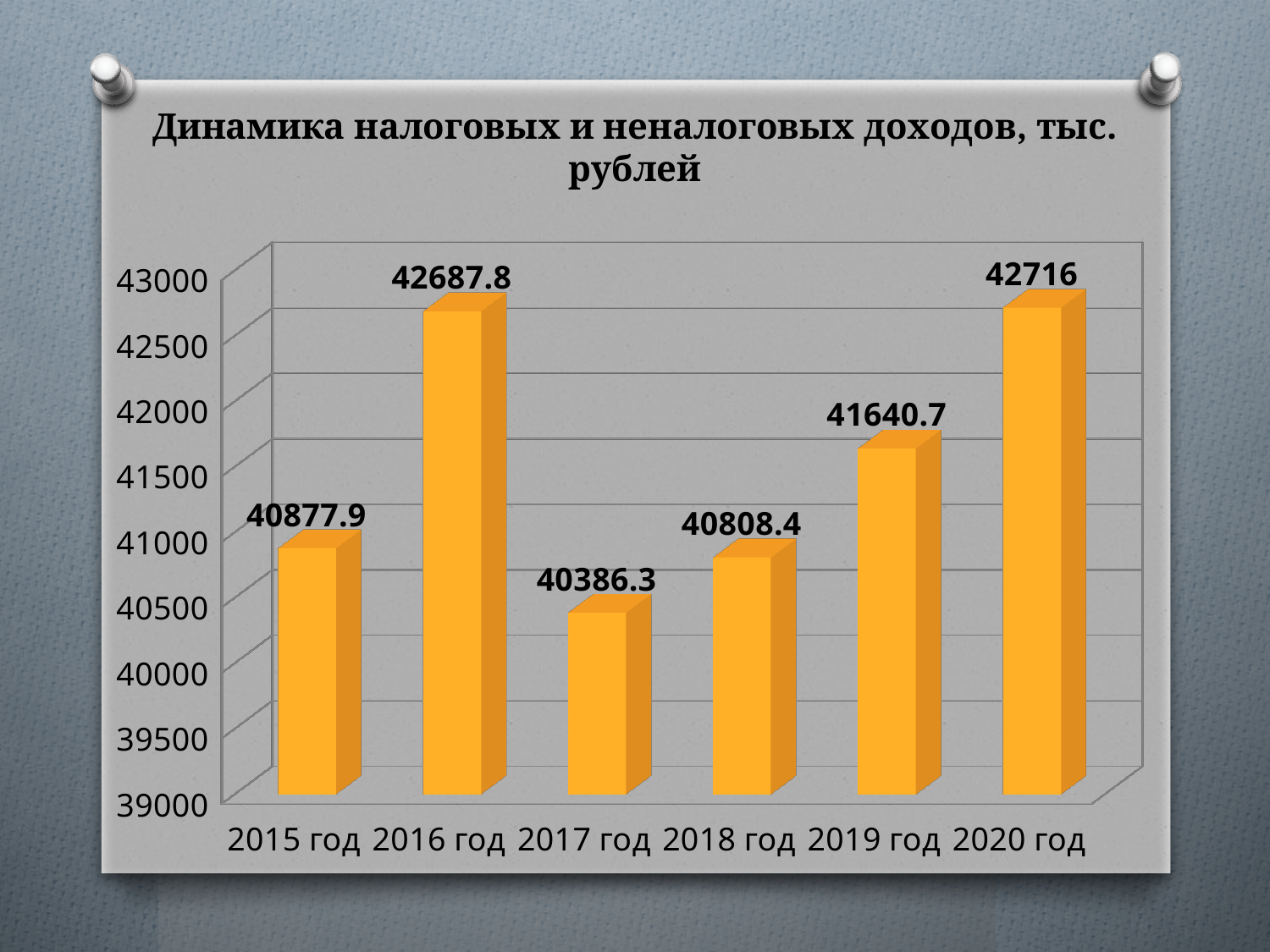
What is the difference between the values for 2016 год and 2015 год? 1809.9 How many years are shown on the x axis? 6 What is the value for 2016 год? 42687.8 What is the value for 2019 год? 41640.7 Which year has the lowest value? 2017 год What is the value for 2015 год? 40877.9 Which year has the highest value? 2020 год Is the value for 2017 год greater or less than 40500? less What is the difference between the values for 2018 год and 2017 год? 422.1 Which is larger, the value for 2018 год or the value for 2019 год? 2019 год Do the values rise or fall from 2017 год to 2020 год? rise What kind of chart is shown on the slide? bar chart